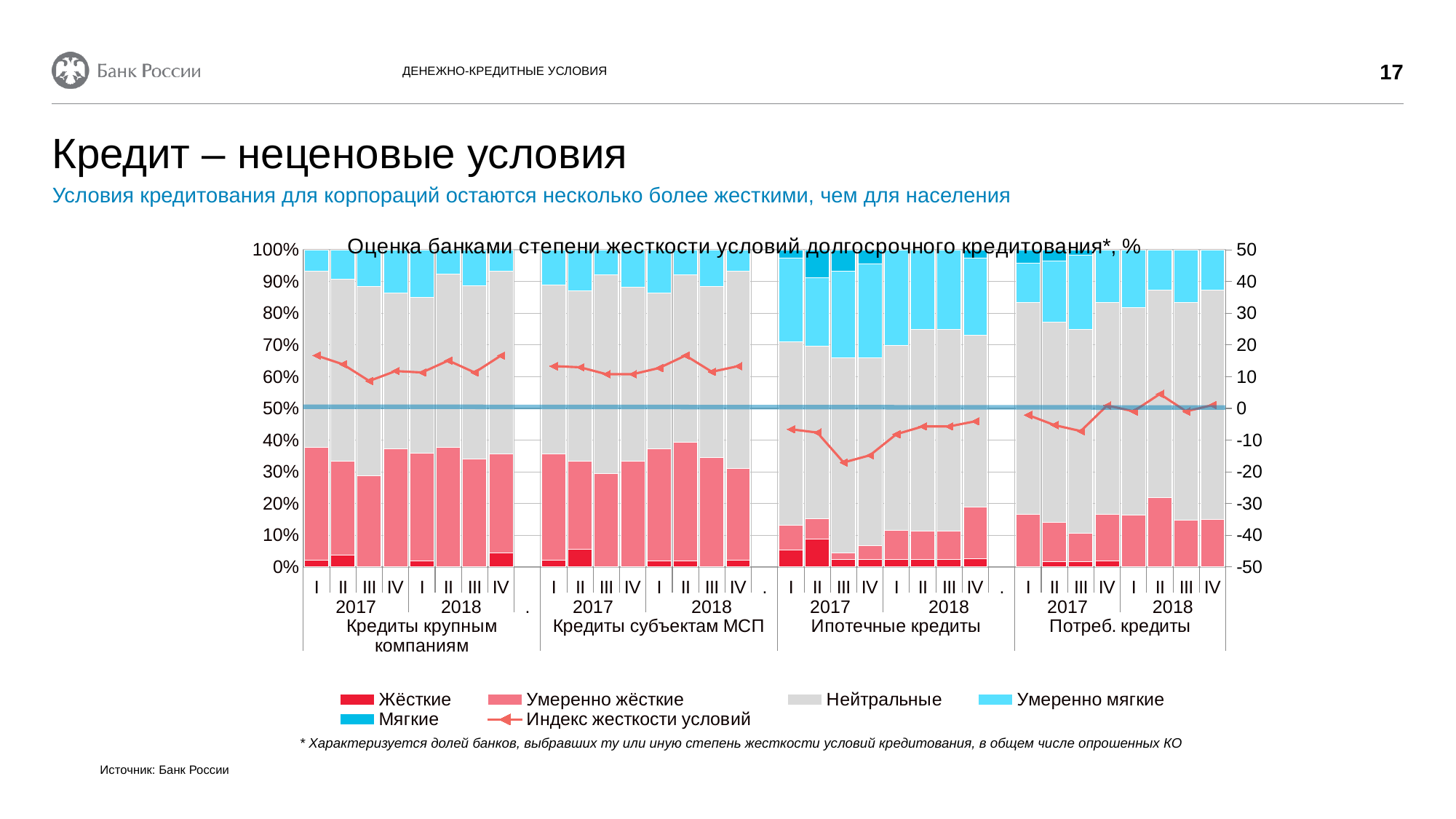
How many series does the legend list? 6 Is the combined share of 'Жёсткие' and 'Умеренно жёсткие' for 'Ипотечные кредиты' in quarter I of 2017 greater or less than 20%? less What kind of chart is shown on the slide? Stacked bar chart with a line What is the title of the chart? Оценка банками степени жесткости условий долгосрочного кредитования*, % Does the 'Индекс жесткости условий' for 'Ипотечные кредиты' rise or fall from quarter III of 2017 to quarter IV of 2018? rise Which loan category has the lowest 'Индекс жесткости условий' in quarter III of 2017? Ипотечные кредиты Is the value of 'Индекс жесткости условий' for 'Потреб. кредиты' in quarter II of 2018 greater or less than 0? greater Is the value of 'Индекс жесткости условий' for 'Ипотечные кредиты' in quarter III of 2017 greater or less than -10? less How many loan categories are shown along the x axis? 4 How many quarterly bars are shown for the category 'Ипотечные кредиты'? 8 In quarter I of 2017, which is larger: the 'Индекс жесткости условий' for 'Кредиты крупным компаниям' or for 'Ипотечные кредиты'? Кредиты крупным компаниям